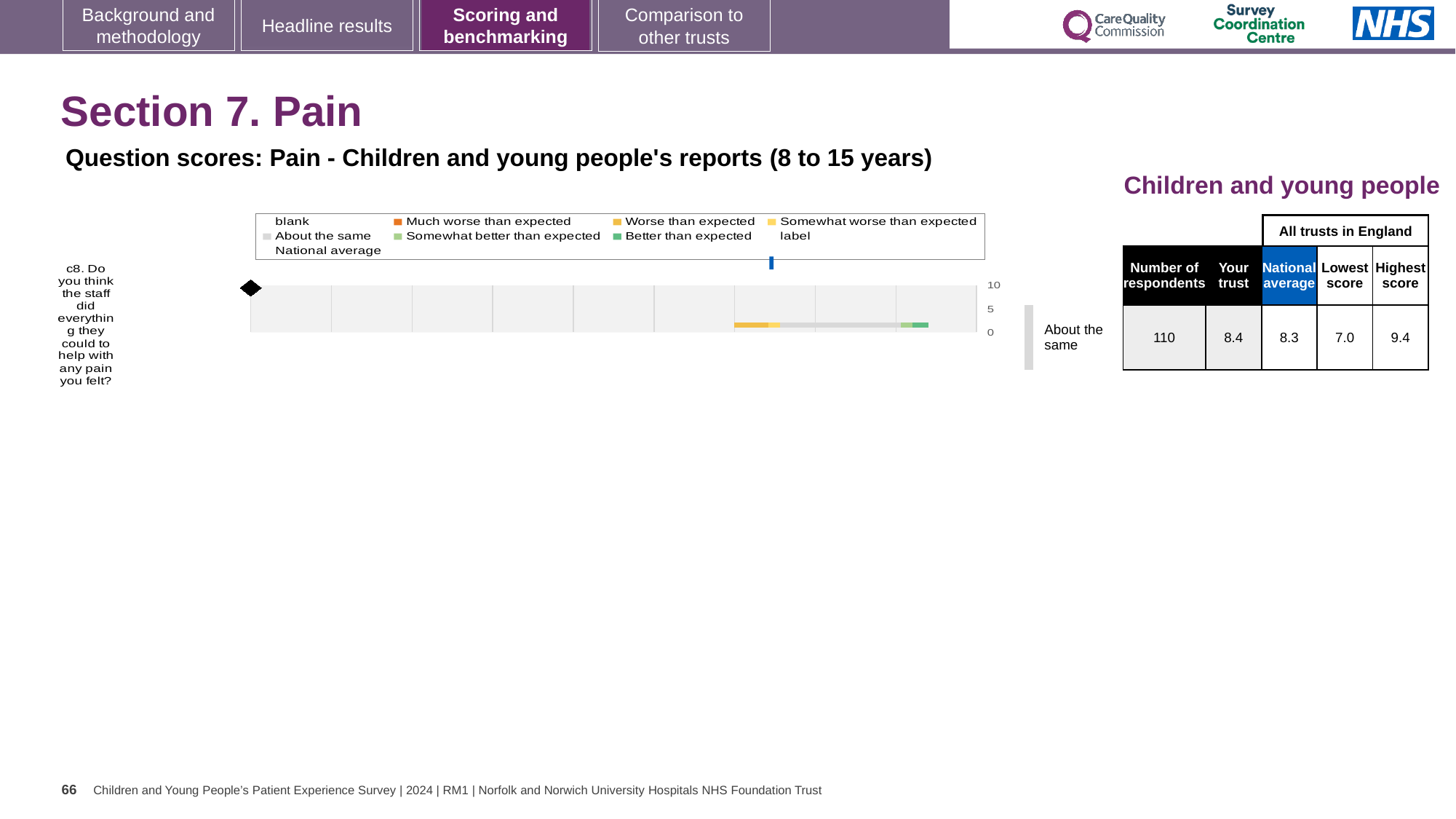
What kind of chart is shown on the slide? bar chart In the table beside the chart, what is the lowest score among all trusts in England for question c8? 7.0 Which is larger for question c8: the 'Your trust' score or the national average? Your trust In the table beside the chart, how many respondents answered question c8? 110 In the table beside the chart, what is the 'Your trust' score for question c8? 8.4 Which legend entry is shown in dark green? Better than expected In the table beside the chart, what is the highest score among all trusts in England for question c8? 9.4 What benchmark category is shown next to the chart for question c8? About the same How many survey questions are plotted in the chart? 1 What is the highest value shown on the chart's axis? 10 What is the difference between the highest score and the lowest score for question c8 in the table? 2.4 In the table beside the chart, what is the national average score for question c8? 8.3